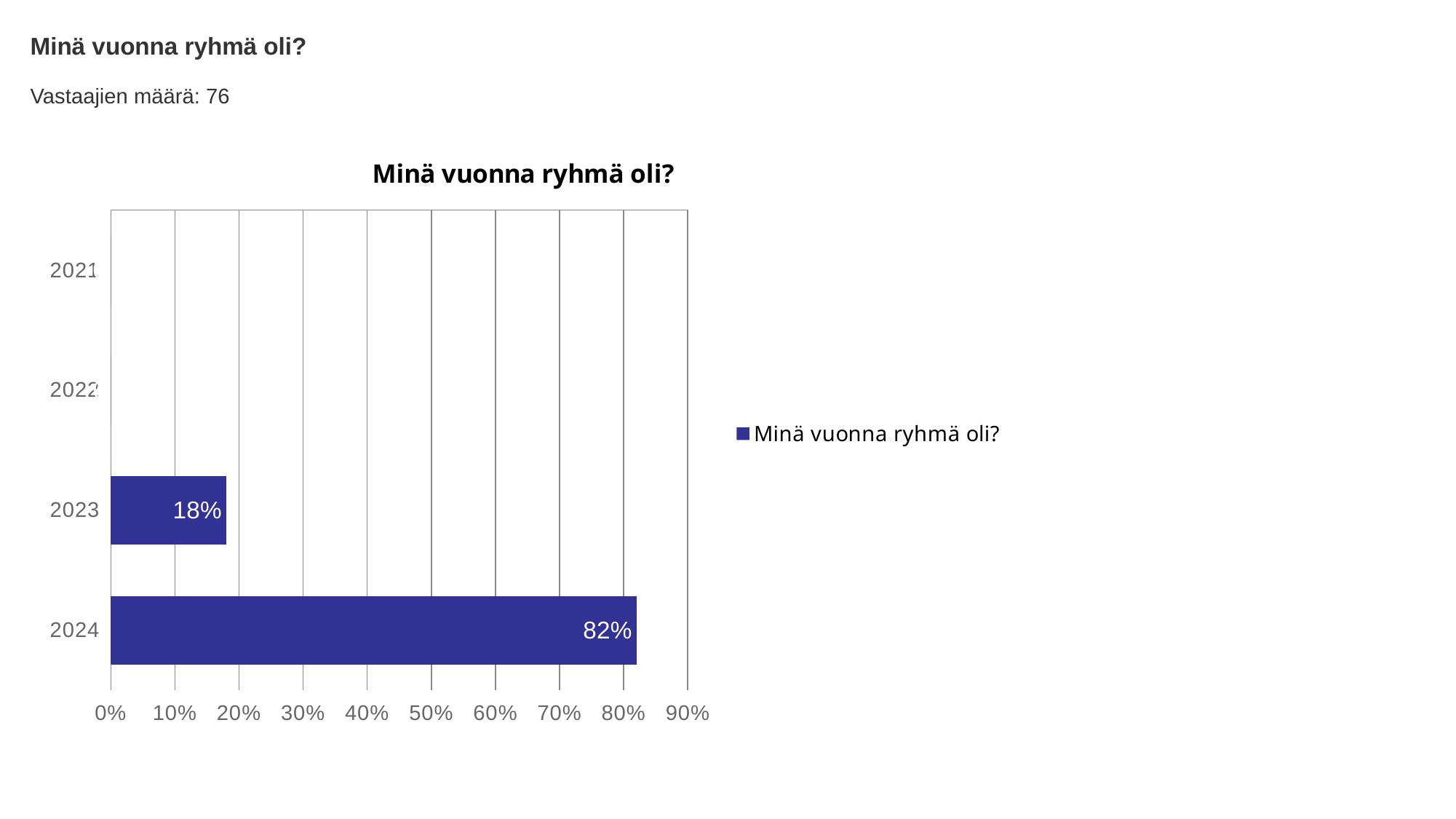
Is the value for 2024 greater or less than 80%? greater What is the value for 2023? 18% Is the value for 2023 greater or less than 20%? less What is the difference between the values for 2024 and 2023? 64% How many year categories are shown on the vertical axis? 4 What kind of chart is shown? bar chart Which year has the highest value? 2024 What is the title of the chart? Minä vuonna ryhmä oli? How many series does the legend list? 1 What is the number of respondents (Vastaajien määrä) stated on the slide? 76 What is the value for 2024? 82% Which is larger, the value for 2023 or the value for 2024? 2024